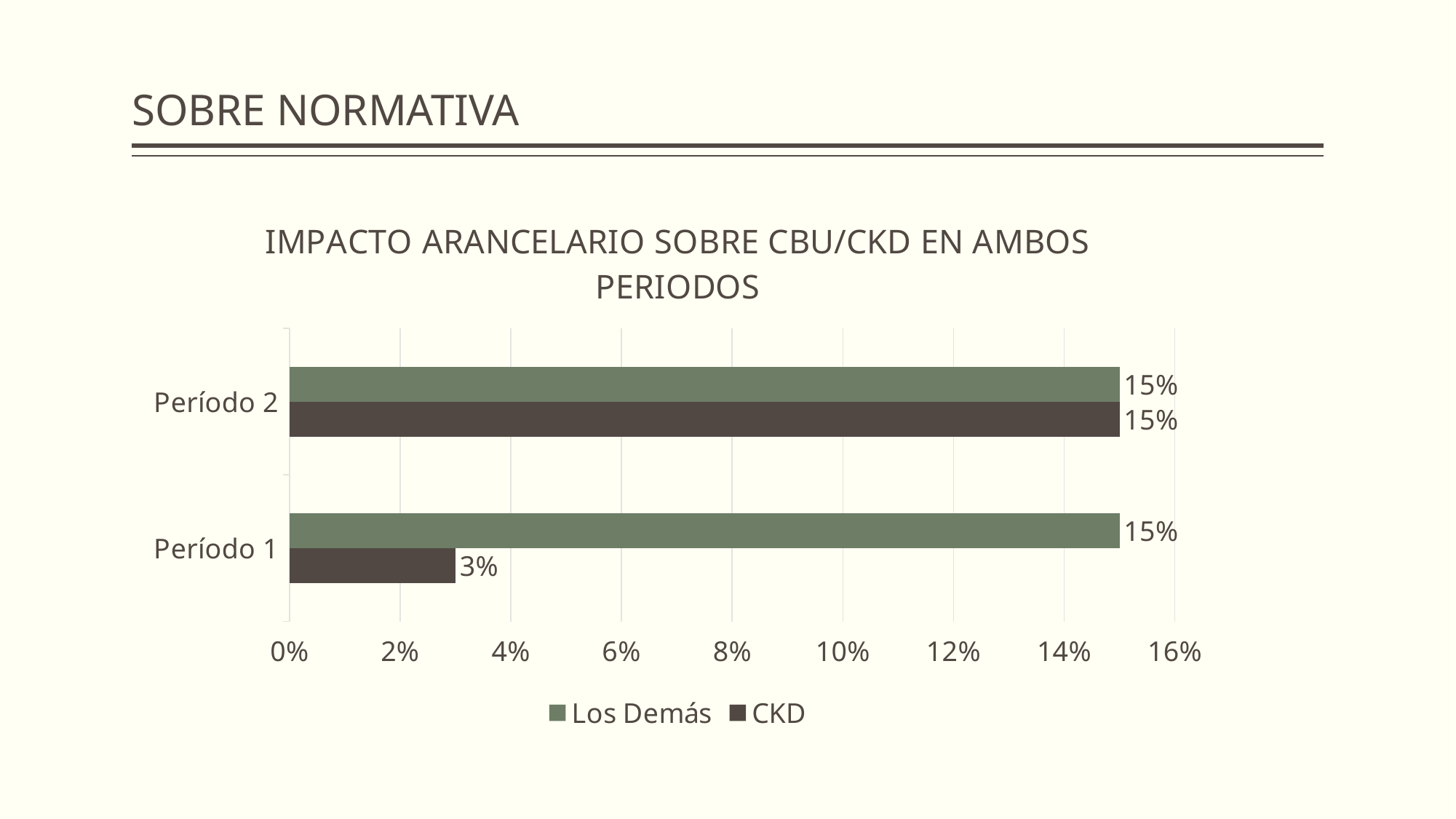
What is the title of the chart? IMPACTO ARANCELARIO SOBRE CBU/CKD EN AMBOS PERIODOS What kind of chart is shown on the slide? Bar chart What is the value for CKD in Período 2? 15% Which is larger in Período 1, Los Demás or CKD? Los Demás How many series does the legend list? 2 What is the value for Los Demás in Período 2? 15% What is the value for Los Demás in Período 1? 15% What is the value for CKD in Período 1? 3% What is the difference between Los Demás and CKD in Período 1? 12% How many categories (periods) are shown on the chart? 2 Is the value for CKD in Período 1 greater or less than 4%? less Which series has the lowest value in Período 1? CKD